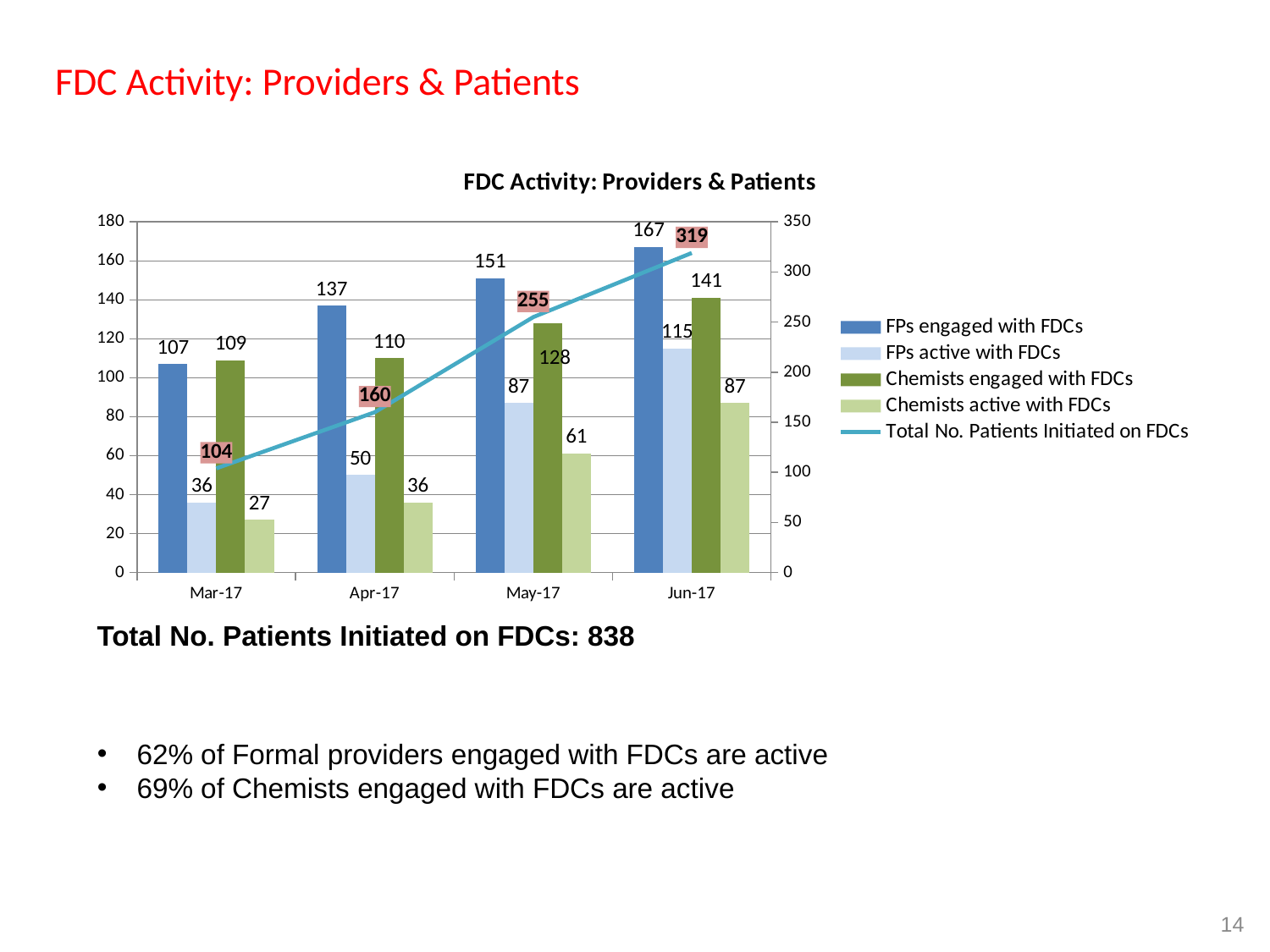
How many series does the legend list? 5 In which month is the value for FPs active with FDCs highest? Jun-17 What is the difference between FPs engaged with FDCs and FPs active with FDCs in May-17? 64 What is the value for Chemists active with FDCs in May-17? 61 How many months are shown on the x axis? 4 In which month is the value for Chemists active with FDCs lowest? Mar-17 Which is larger in Mar-17: FPs engaged with FDCs or Chemists engaged with FDCs? Chemists engaged with FDCs Does the Total No. Patients Initiated on FDCs line rise or fall from Mar-17 to Jun-17? Rise What is the title of the chart? FDC Activity: Providers & Patients What kind of chart is this? Combined bar and line chart What is the value for FPs engaged with FDCs in Apr-17? 137 What is the Total No. Patients Initiated on FDCs in Jun-17? 319